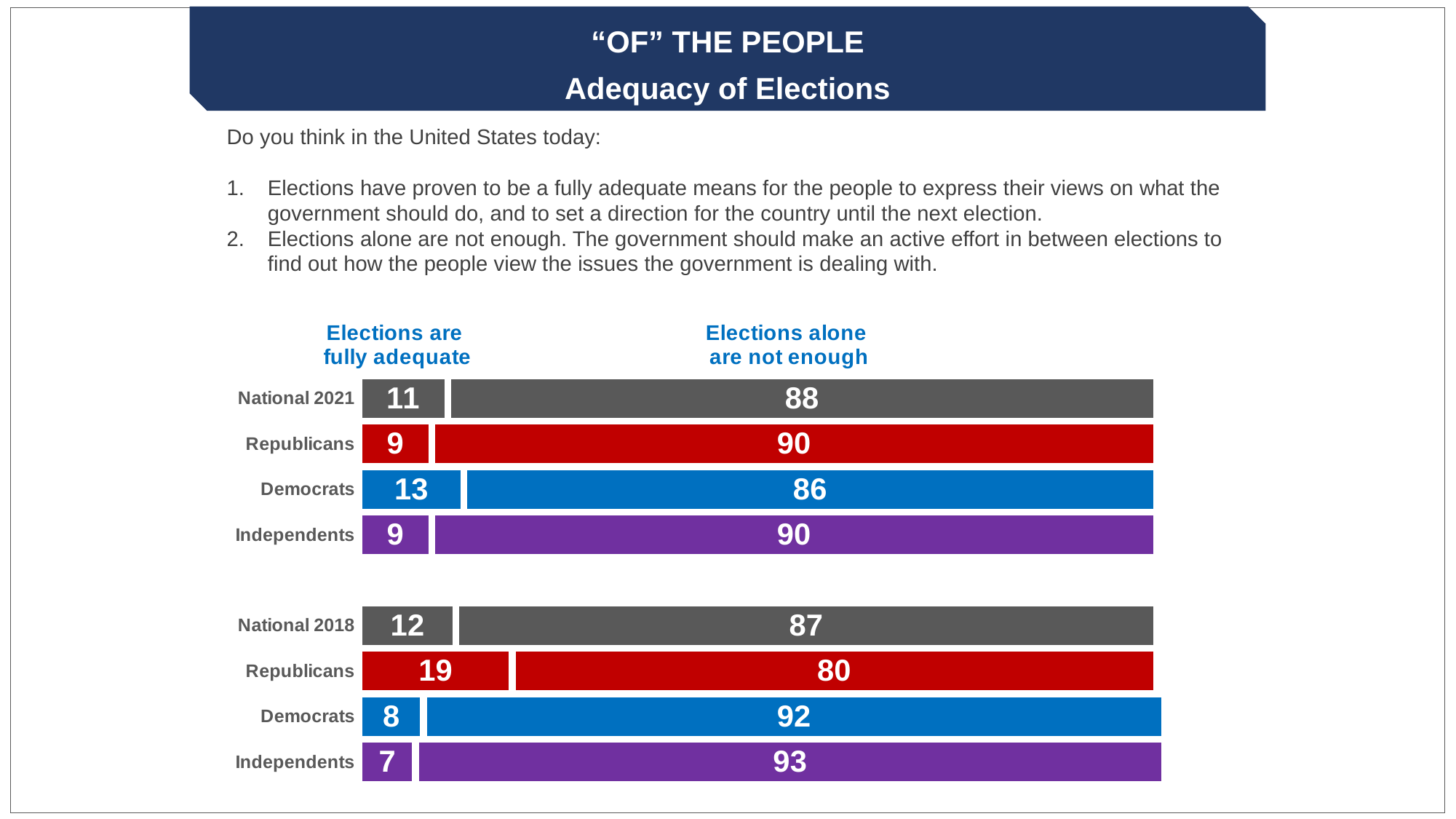
What kind of chart is shown on the slide? Stacked bar chart In the 2018 group, what value is shown for Independents in the "Elections alone are not enough" segment? 93 What colour are the bars for Democrats? Blue In the 2018 group (below National 2018), what value is shown for Republicans in the "Elections are fully adequate" segment? 19 In the 2018 group, which is larger: the "Elections alone are not enough" value for Democrats or for Republicans? Democrats How many bars are plotted in the chart in total? 8 What value is shown for National 2021 in the "Elections alone are not enough" segment? 88 In the 2021 group (National 2021, Republicans, Democrats, Independents), which category has the highest "Elections are fully adequate" value? Democrats In the 2018 group, which category has the lowest "Elections are fully adequate" value? Independents How many series (response options) does the chart show? 2 What is the total of the two segments in the National 2021 bar? 99 What is the difference between the Republicans' "Elections are fully adequate" value in the 2018 group and in the 2021 group? 10